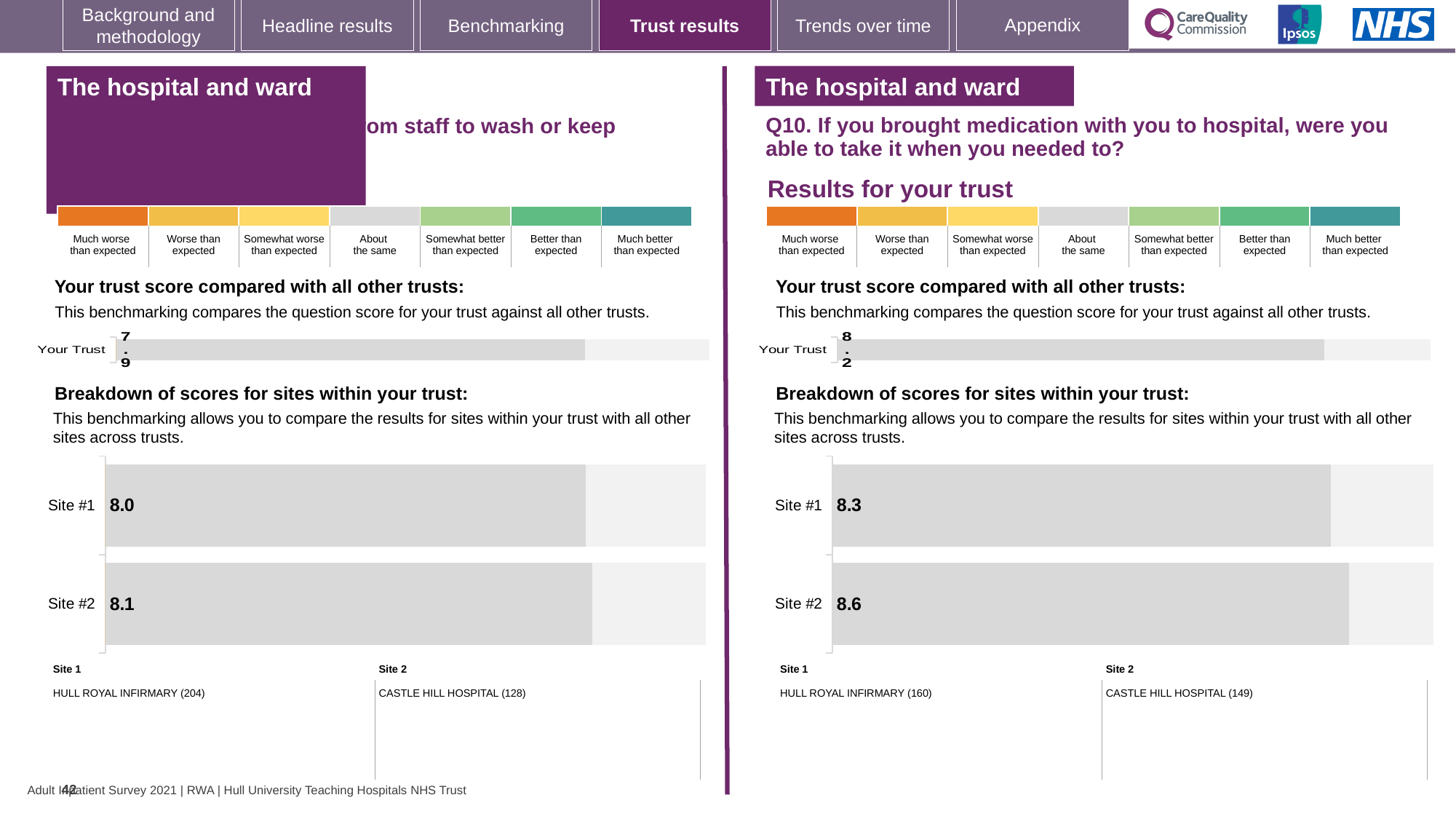
In the right-hand site breakdown chart, which site has the higher score? Site #2 In the left-hand 'Breakdown of scores for sites within your trust' chart, what is the score for Site #2? 8.1 In the left-hand 'Breakdown of scores for sites within your trust' chart, what is the score for Site #1? 8.0 On the right-hand side of the slide (Q10), what is the score shown for Your Trust? 8.2 In the right-hand site breakdown chart, what is the difference between the Site #2 and Site #1 scores? 0.3 In the right-hand site breakdown chart, is the Site #1 score larger or smaller than the Your Trust score on the same side? Larger In the right-hand 'Breakdown of scores for sites within your trust' chart, what is the score for Site #1? 8.3 In the left-hand site breakdown chart, what is the difference between the Site #2 and Site #1 scores? 0.1 What type of chart is used for the site breakdown on the right-hand side of the slide? Bar chart In the right-hand 'Breakdown of scores for sites within your trust' chart, what is the score for Site #2? 8.6 How many sites are shown in the right-hand site breakdown chart? 2 On the left-hand side of the slide, what is the score shown for Your Trust? 7.9